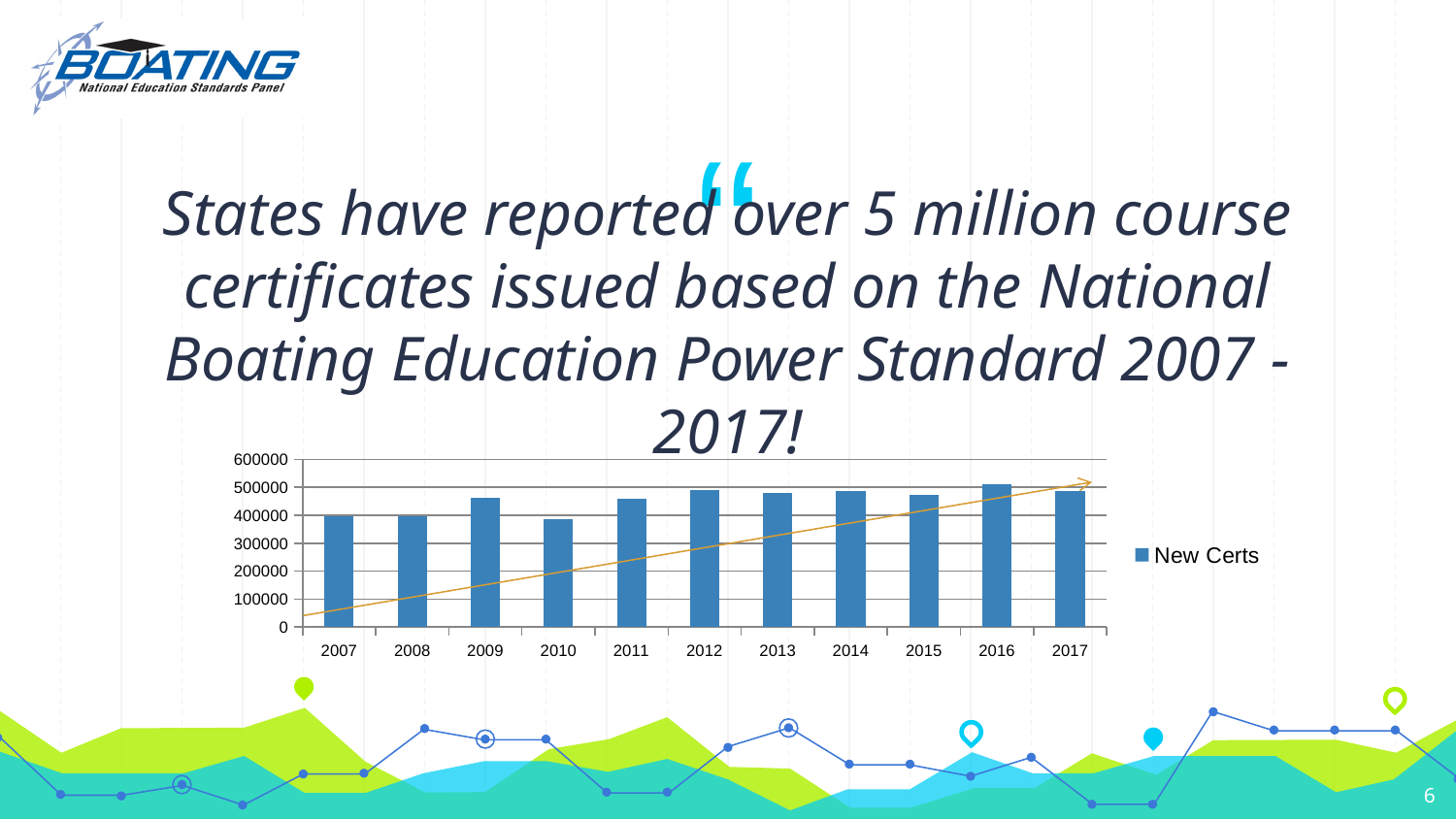
What is the name of the series shown in the chart's legend? New Certs Is the value for 2010 greater or less than 400000? less Is the value for 2016 greater or less than 500000? greater What kind of chart is shown on the slide? bar chart Which year has the lowest value for New Certs? 2010 How many years are shown on the x axis of the chart? 11 Which year has the highest value for New Certs? 2016 Is the value for 2009 greater or less than 500000? less Which year has a larger value for New Certs, 2009 or 2010? 2009 How many series does the chart's legend list? 1 Do the values for New Certs generally rise or fall from 2007 to 2017? rise